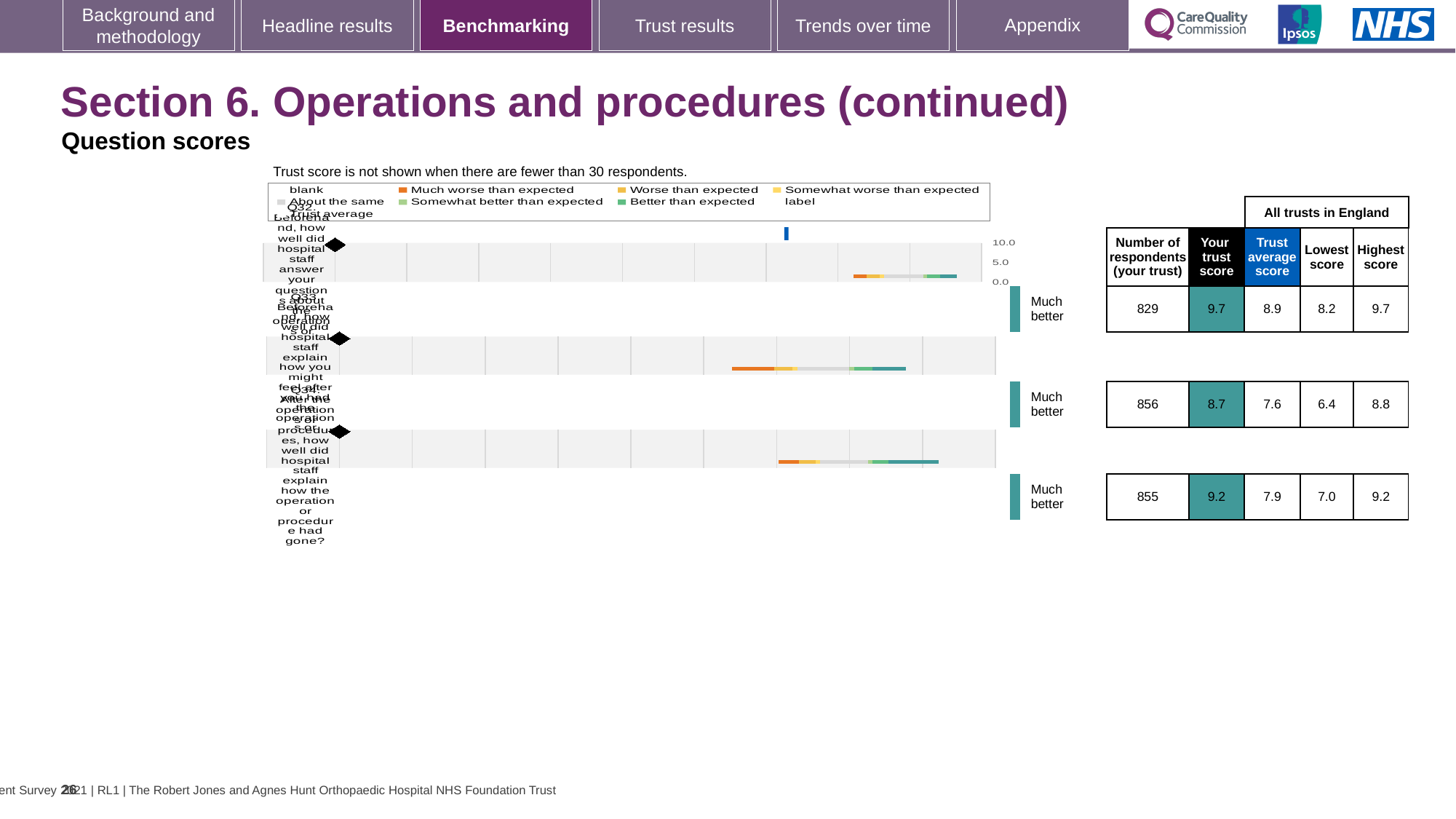
What type of chart is used to show the question scores on this slide? bar chart What is the 'Your trust score' for the third question row (Q34)? 9.2 How many question rows are plotted in the benchmarking chart? 3 What is the difference between the trust score and the trust average score for the third question row (Q34)? 1.3 Which question row has the lowest 'Your trust score'? Q33 (second row) What is the trust average score for the second question row (Q33)? 7.6 Is the trust score for the second question row (Q33) greater or less than the trust average score for that row? greater What is the 'Your trust score' for the second question row (Q33)? 8.7 What is the highest score across all trusts in England for the second question row (Q33)? 8.8 What is the number of respondents for the first question row (Q32)? 829 What is the maximum value shown on the chart's score axis? 10.0 What is the 'Your trust score' for the first question row (Q32)? 9.7